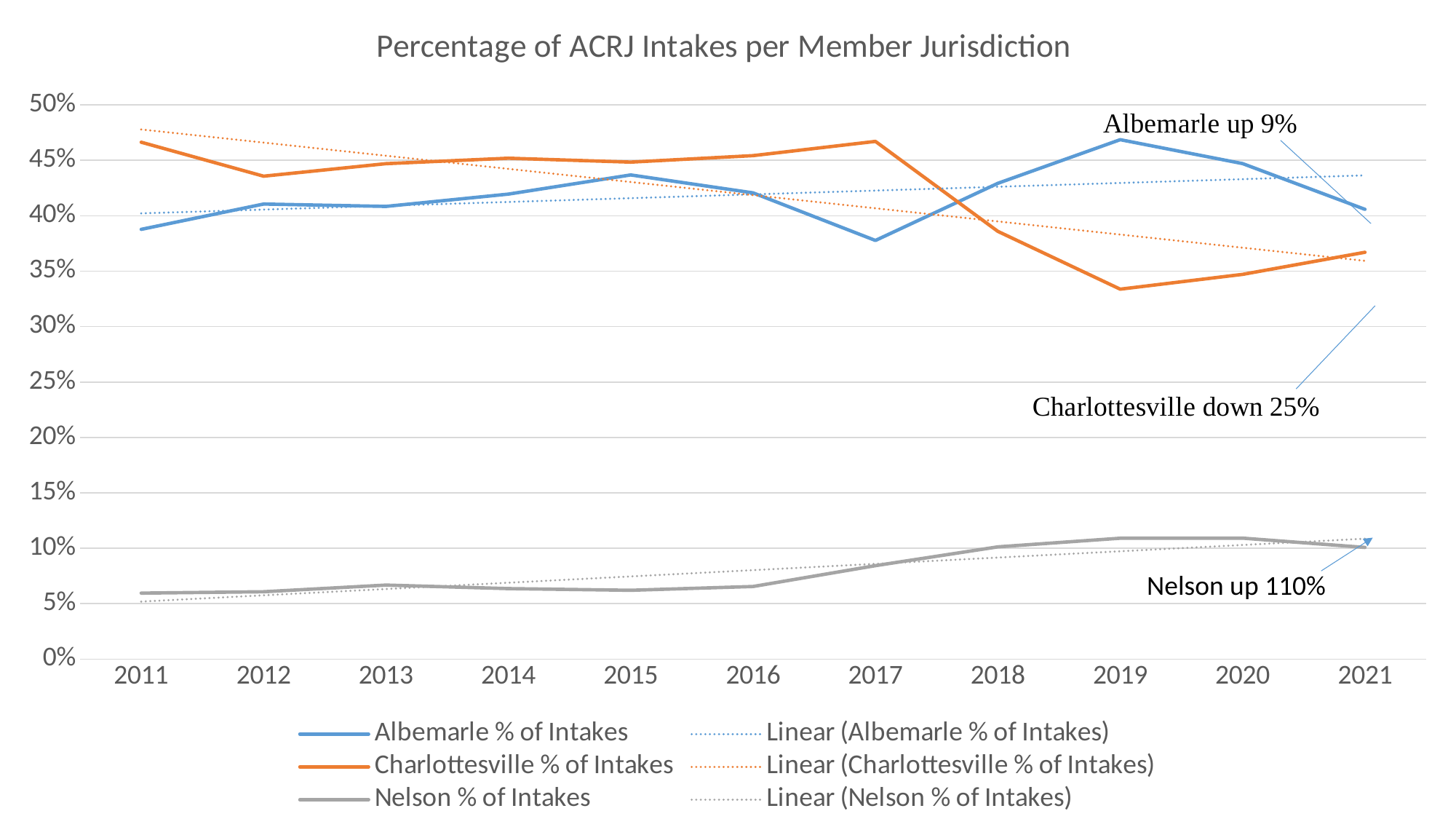
In 2017, which is larger: Albemarle % of Intakes or Charlottesville % of Intakes? Charlottesville % of Intakes In which year does the Charlottesville % of Intakes line reach its lowest value? 2019 Is the value for Nelson % of Intakes in 2011 greater or less than 10%? less What kind of chart is shown on the slide? Line chart How many entries does the legend list? 6 According to the annotation on the chart, by what percentage is Nelson up? 110% Is the value for Albemarle % of Intakes in 2019 greater or less than 45%? greater What is the title of the chart? Percentage of ACRJ Intakes per Member Jurisdiction In 2019, which is larger: Albemarle % of Intakes or Charlottesville % of Intakes? Albemarle % of Intakes Does the Nelson % of Intakes line generally rise or fall from 2011 to 2021? Rise How many years are plotted along the x axis? 11 In which year does the Albemarle % of Intakes line reach its highest value? 2019